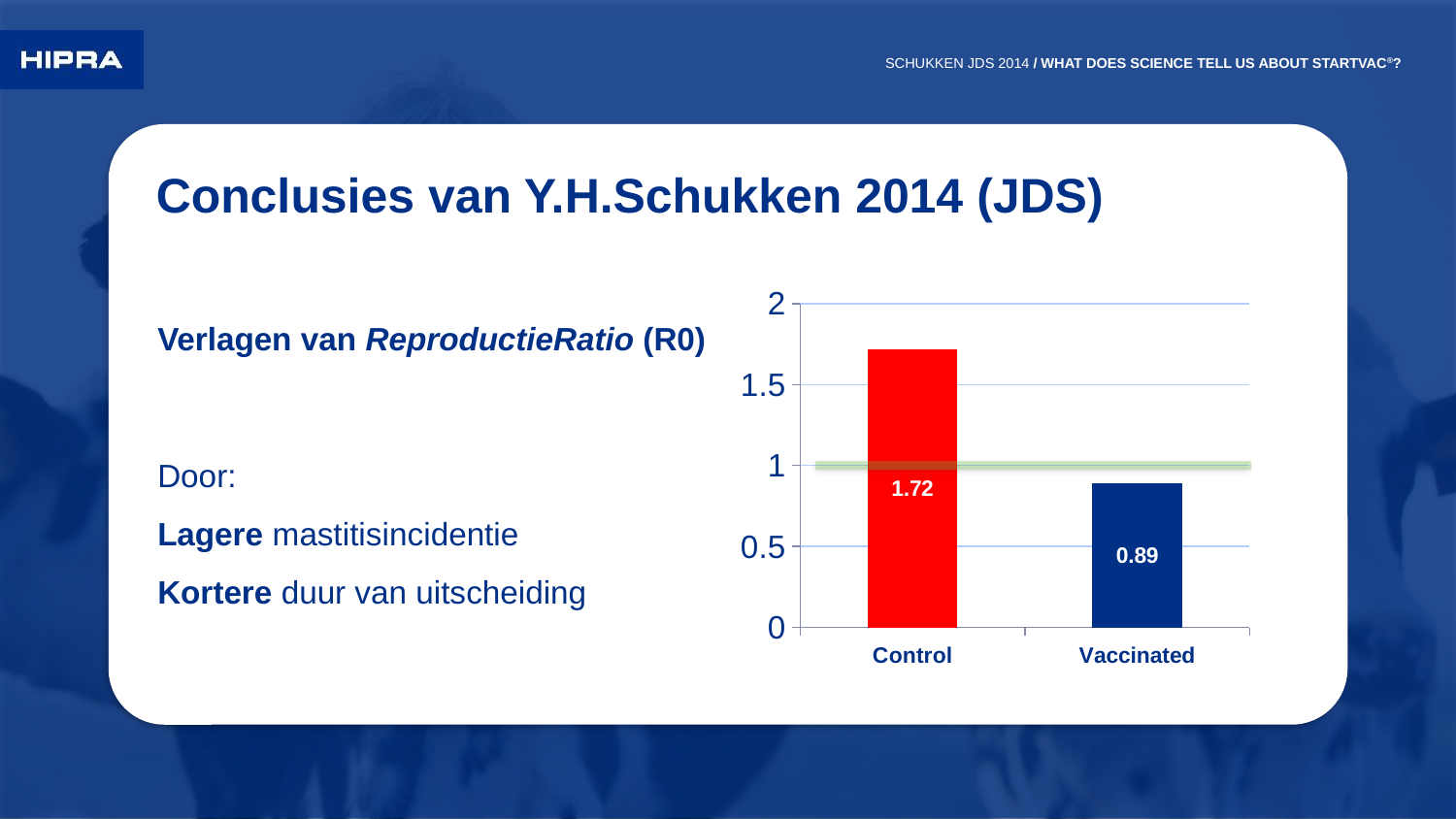
How many categories are shown on the x axis? 2 What is the value for Control? 1.72 Which is larger, the value for Control or the value for Vaccinated? Control What is the value for Vaccinated? 0.89 Which category has the lowest value? Vaccinated What is the maximum value shown on the y axis? 2 What kind of chart is shown on the slide? bar chart What is the difference between the Control and Vaccinated values? 0.83 Is the value for Vaccinated greater or less than 1? less What colour is the Control bar? red Which category has the highest value? Control Is the value for Control greater or less than 1.5? greater